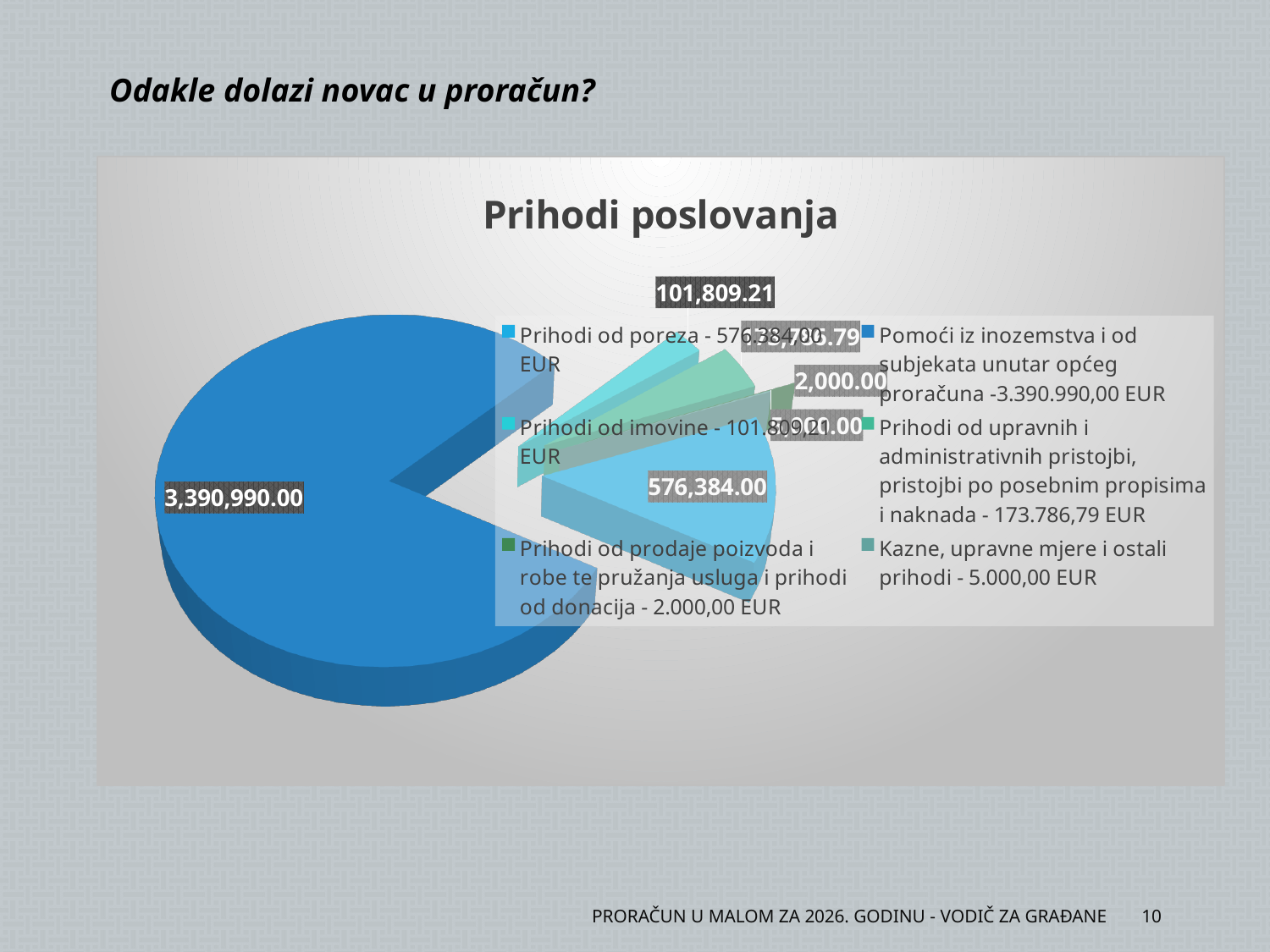
How many entries does the legend list? 6 How many slices does the pie chart have? 6 What is the value shown for Prihodi od imovine? 101,809.21 What is the title of the chart? Prihodi poslovanja What kind of chart is shown on the slide? Pie chart What is the value shown for the largest slice of the pie? 3,390,990.00 What is the value shown for Prihodi od poreza? 576,384.00 According to the legend, what is the value for Kazne, upravne mjere i ostali prihodi? 5.000,00 EUR Which is larger: Prihodi od poreza or Prihodi od imovine? Prihodi od poreza What is the difference between the value for Pomoći iz inozemstva i od subjekata unutar općeg proračuna and the value for Prihodi od poreza? 2,814,606.00 Which category has the largest slice of the pie? Pomoći iz inozemstva i od subjekata unutar općeg proračuna Which category has the smallest slice of the pie? Prihodi od prodaje poizvoda i robe te pružanja usluga i prihodi od donacija